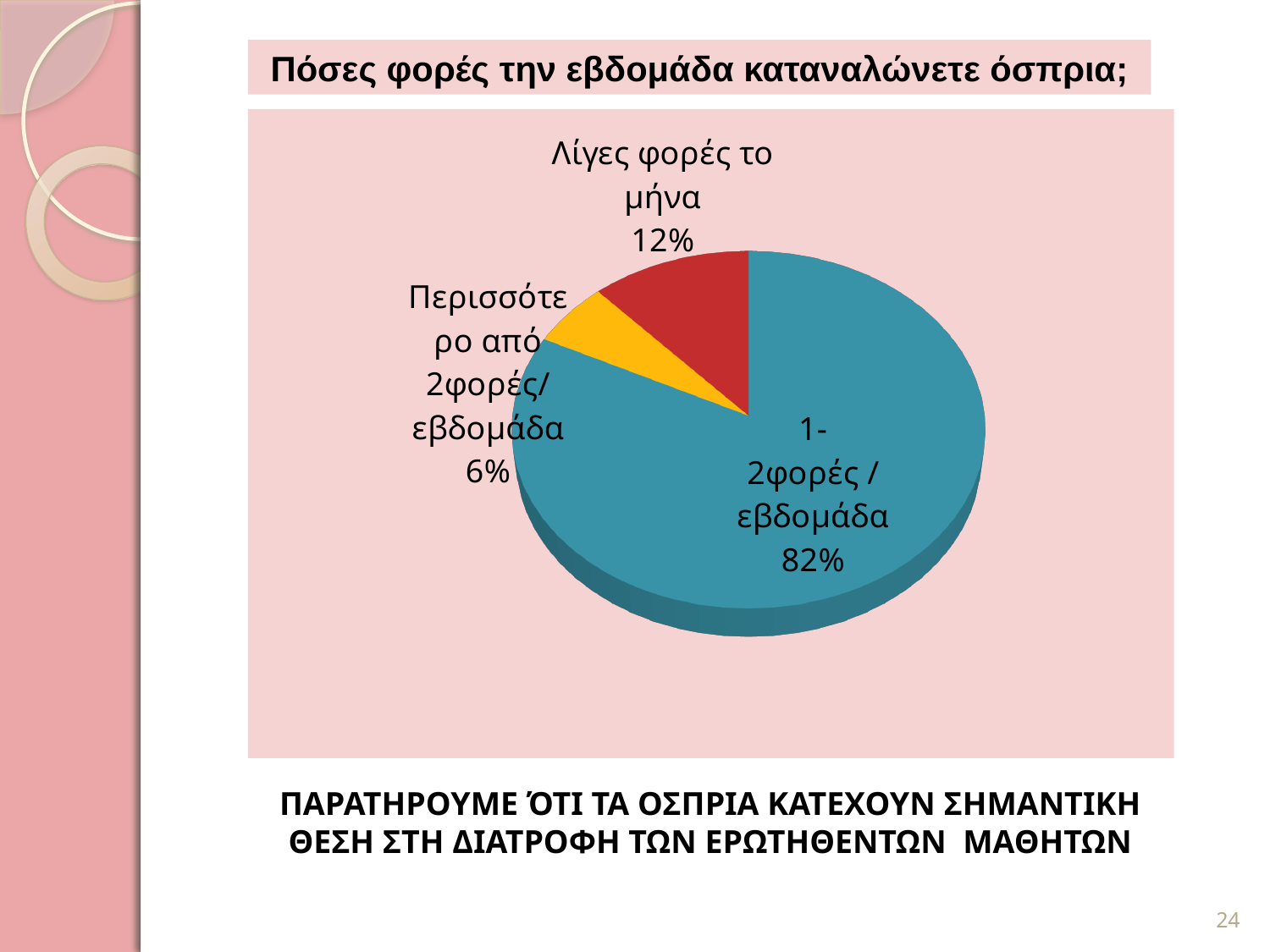
What percentage of respondents consume legumes a few times a month (Λίγες φορές το μήνα)? 12% What kind of chart is shown on the slide? pie chart What is the title of the chart? Πόσες φορές την εβδομάδα καταναλώνετε όσπρια; Which category has the largest share of the pie? 1-2φορές / εβδομάδα What is the difference in percentage points between '1-2φορές / εβδομάδα' and 'Λίγες φορές το μήνα'? 70% Which category has the smallest share of the pie? Περισσότερο από 2φορές/εβδομάδα How many slices does the pie chart have? 3 What percentage of respondents consume legumes 1-2 times per week (1-2φορές / εβδομάδα)? 82% What percentage of respondents consume legumes more than 2 times per week (Περισσότερο από 2φορές/εβδομάδα)? 6% What is the difference in percentage points between 'Λίγες φορές το μήνα' and 'Περισσότερο από 2φορές/εβδομάδα'? 6% Which is larger: the share for 'Λίγες φορές το μήνα' or for 'Περισσότερο από 2φορές/εβδομάδα'? Λίγες φορές το μήνα What colour is the slice for 'Λίγες φορές το μήνα'? red